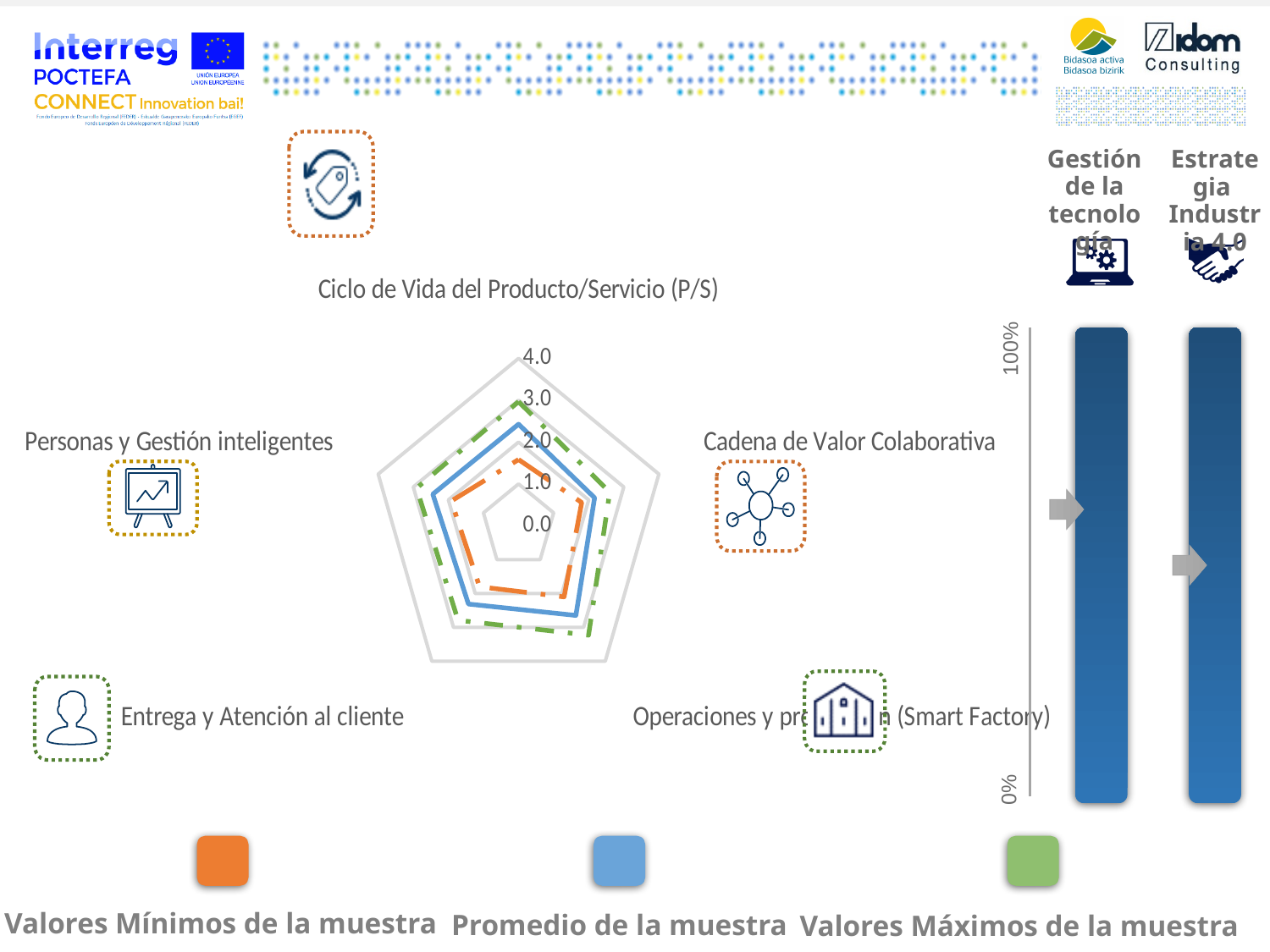
Which series is drawn in orange on the radar chart? Valores Mínimos de la muestra How many series does the legend of the radar chart list? 3 Is the value of Valores Mínimos de la muestra for Ciclo de Vida del Producto/Servicio (P/S) greater or less than 1.0? greater Is the value of Valores Mínimos de la muestra for Ciclo de Vida del Producto/Servicio (P/S) greater or less than 2.0? less How many categories (axes) does the radar chart have? 5 Is the value of Promedio de la muestra for Ciclo de Vida del Producto/Servicio (P/S) greater or less than 3.0? less For Entrega y Atención al cliente, which is larger: Promedio de la muestra or Valores Mínimos de la muestra? Promedio de la muestra What is the highest value shown on the radar chart's scale? 4.0 What kind of chart is shown in the centre of the slide? radar chart For Cadena de Valor Colaborativa, which is larger: Valores Máximos de la muestra or Valores Mínimos de la muestra? Valores Máximos de la muestra Which series is drawn in blue on the radar chart? Promedio de la muestra